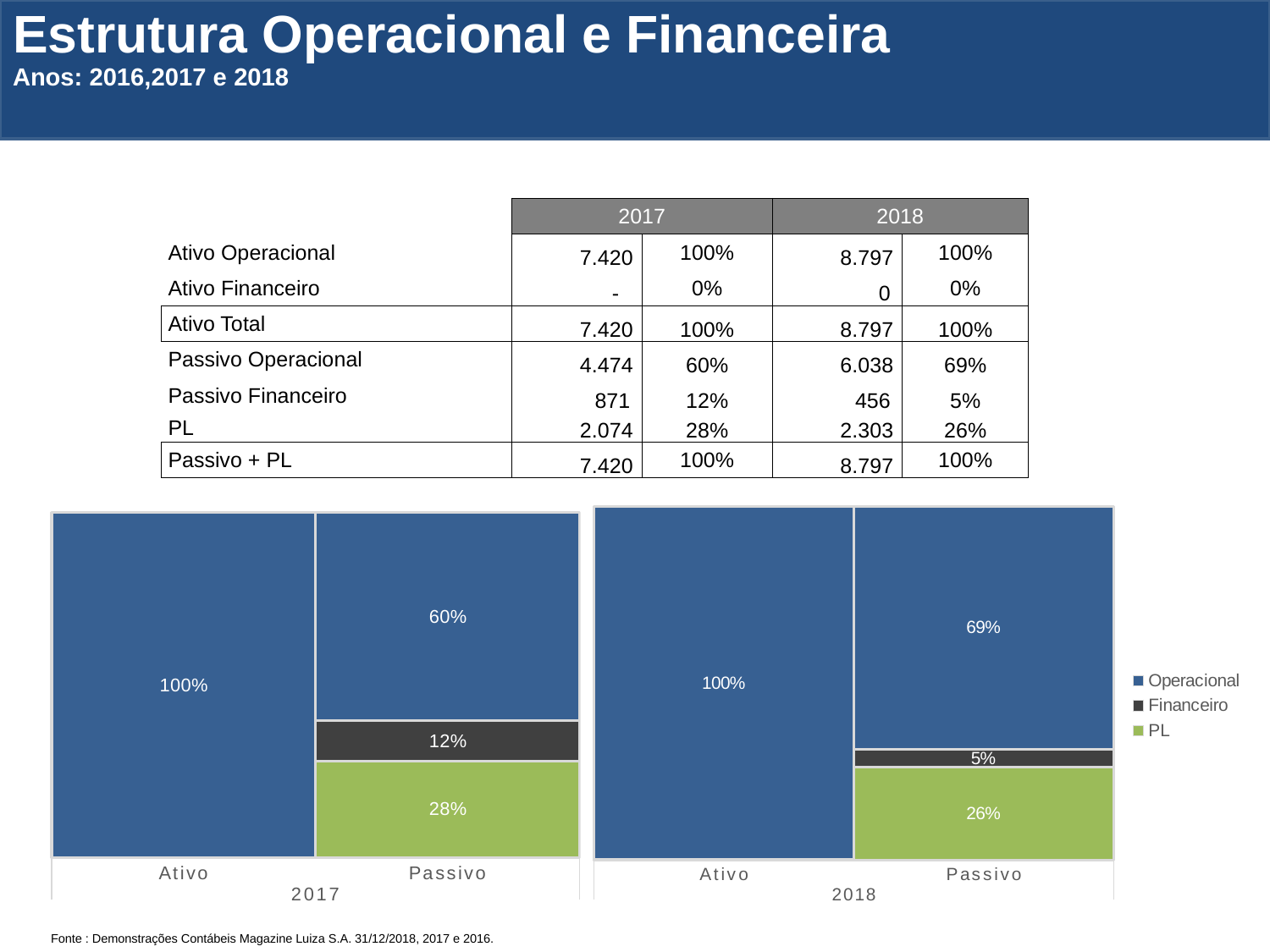
How many bars are shown in the 2017 chart? 2 In the 2017 chart, what is the Operacional share of the Passivo bar? 60% In the 2018 chart, what is the Financeiro share of the Passivo bar? 5% Is the Financeiro share of the Passivo bar larger in the 2017 chart or the 2018 chart? 2017 In the 2017 chart, what is the Operacional share of the Ativo bar? 100% In the 2017 chart, which segment of the Passivo bar is the largest? Operacional In the 2018 chart, what is the Operacional share of the Passivo bar? 69% In the 2017 chart, what is the PL share of the Passivo bar? 28% How many series does the legend list for the charts? 3 What type of chart is the 2018 chart? Stacked bar chart In the 2017 chart, what is the difference between the Operacional and PL shares of the Passivo bar? 32% In the 2018 chart, which segment of the Passivo bar is the smallest? Financeiro